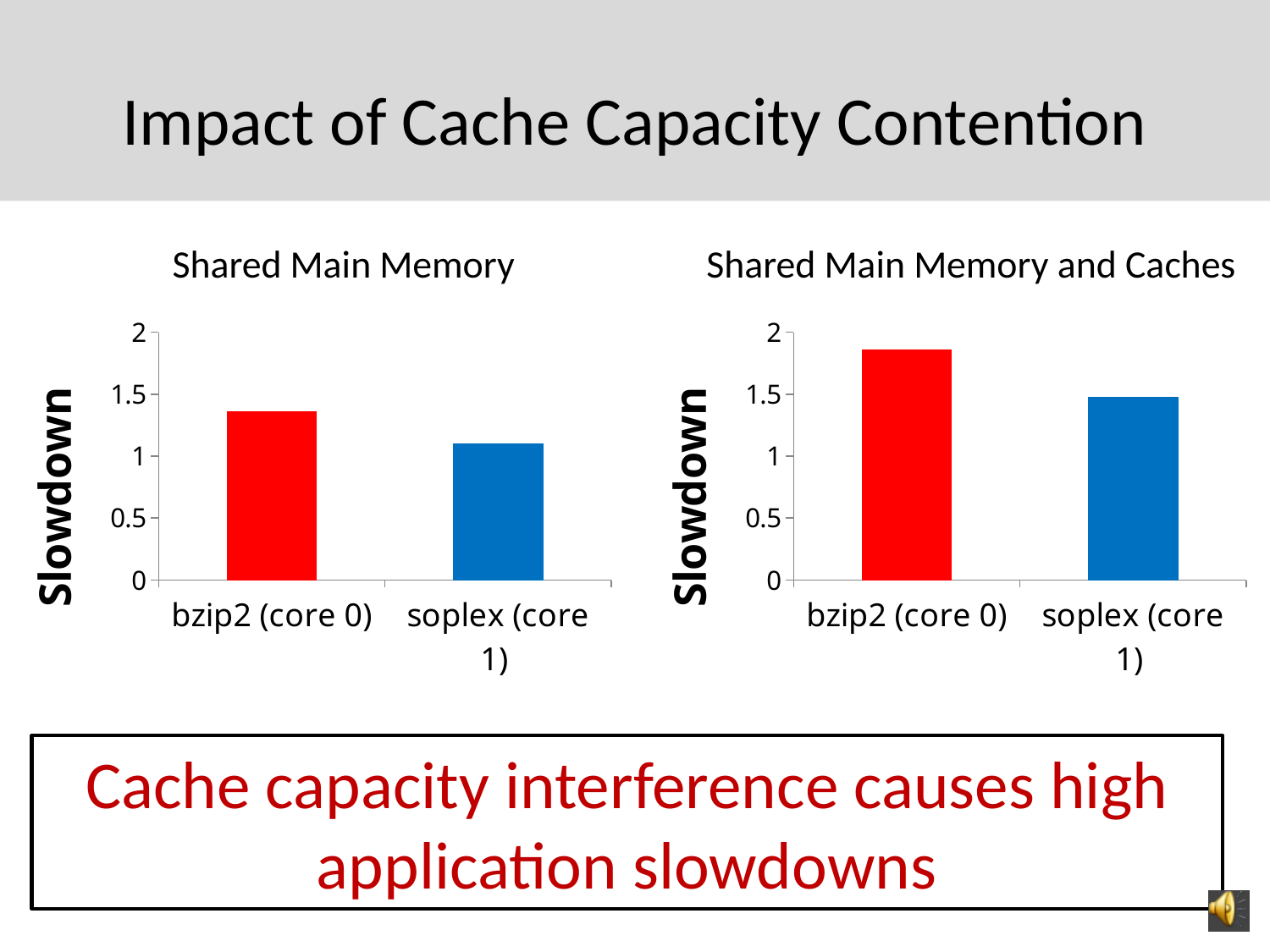
In the "Shared Main Memory and Caches" chart, is the value for soplex (core 1) greater or less than 1? greater What kind of chart is the "Shared Main Memory" chart? bar chart In the "Shared Main Memory" chart, is the value for bzip2 (core 0) greater or less than 1? greater In the "Shared Main Memory and Caches" chart, how many bars are shown? 2 In the "Shared Main Memory" chart, how many categories are plotted? 2 In the "Shared Main Memory and Caches" chart, is the value for bzip2 (core 0) greater or less than 1.5? greater In the "Shared Main Memory and Caches" chart, which category has the lowest slowdown? soplex (core 1) In the "Shared Main Memory and Caches" chart, what colour is the bar for bzip2 (core 0)? red What is the y-axis title of the "Shared Main Memory" chart? Slowdown In the "Shared Main Memory" chart, which category has the highest slowdown? bzip2 (core 0) Is the slowdown for bzip2 (core 0) larger in the "Shared Main Memory" chart or in the "Shared Main Memory and Caches" chart? Shared Main Memory and Caches